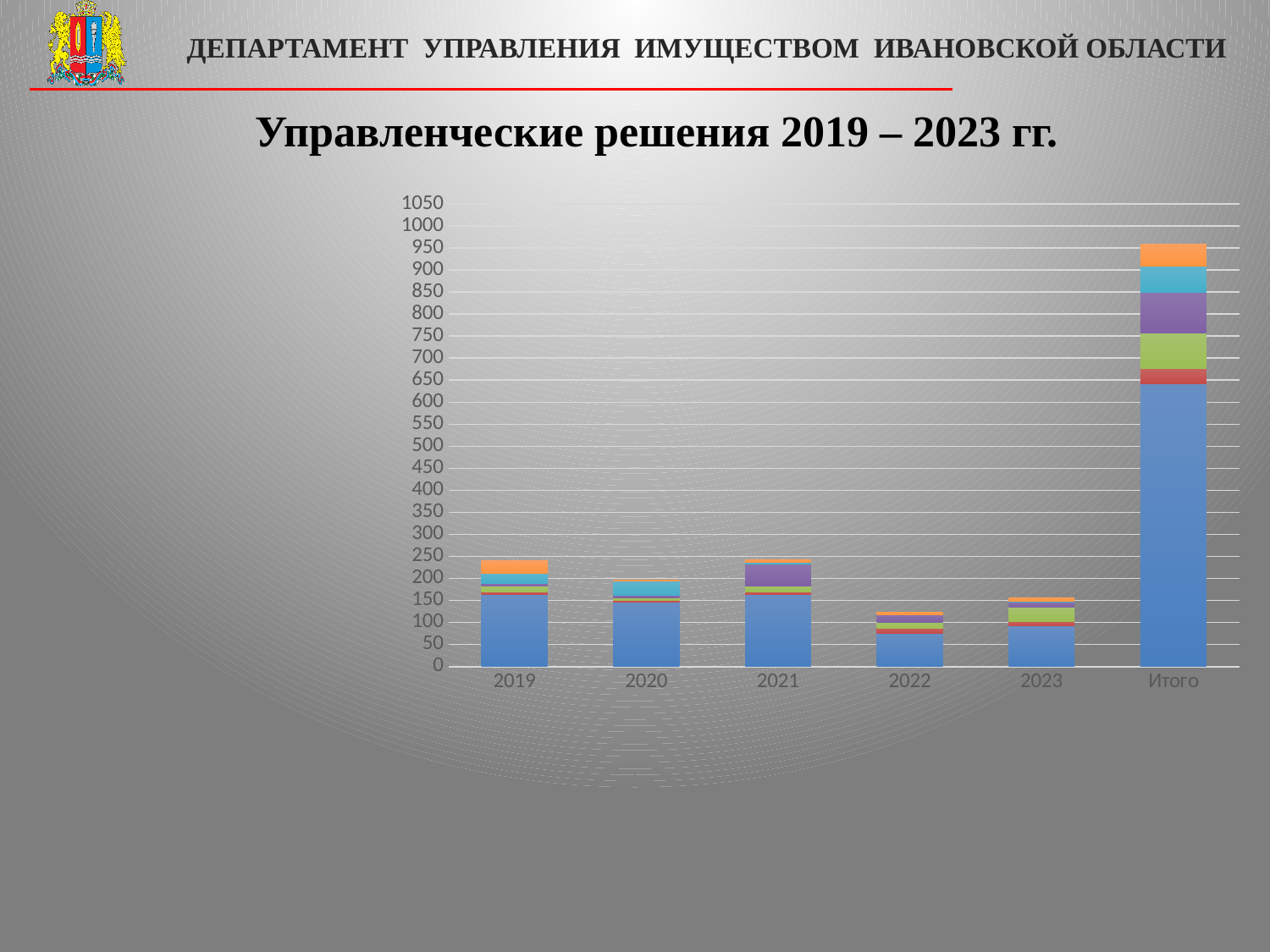
Which bar is taller, 2021 or 2023? 2021 Is the total height of the Итого bar greater or less than 900? greater Is the total height of the 2019 bar greater or less than 200? greater Which bar is taller, 2019 or 2022? 2019 Is the blue segment of the Итого bar greater or less than 600? greater What is the title of the chart on the slide? Управленческие решения 2019 – 2023 гг. How many categories are shown along the x axis of the chart? 6 Which category has the tallest bar in the chart? Итого Which year from 2019 to 2023 has the shortest bar in the chart? 2022 What kind of chart is shown on the slide? stacked bar chart